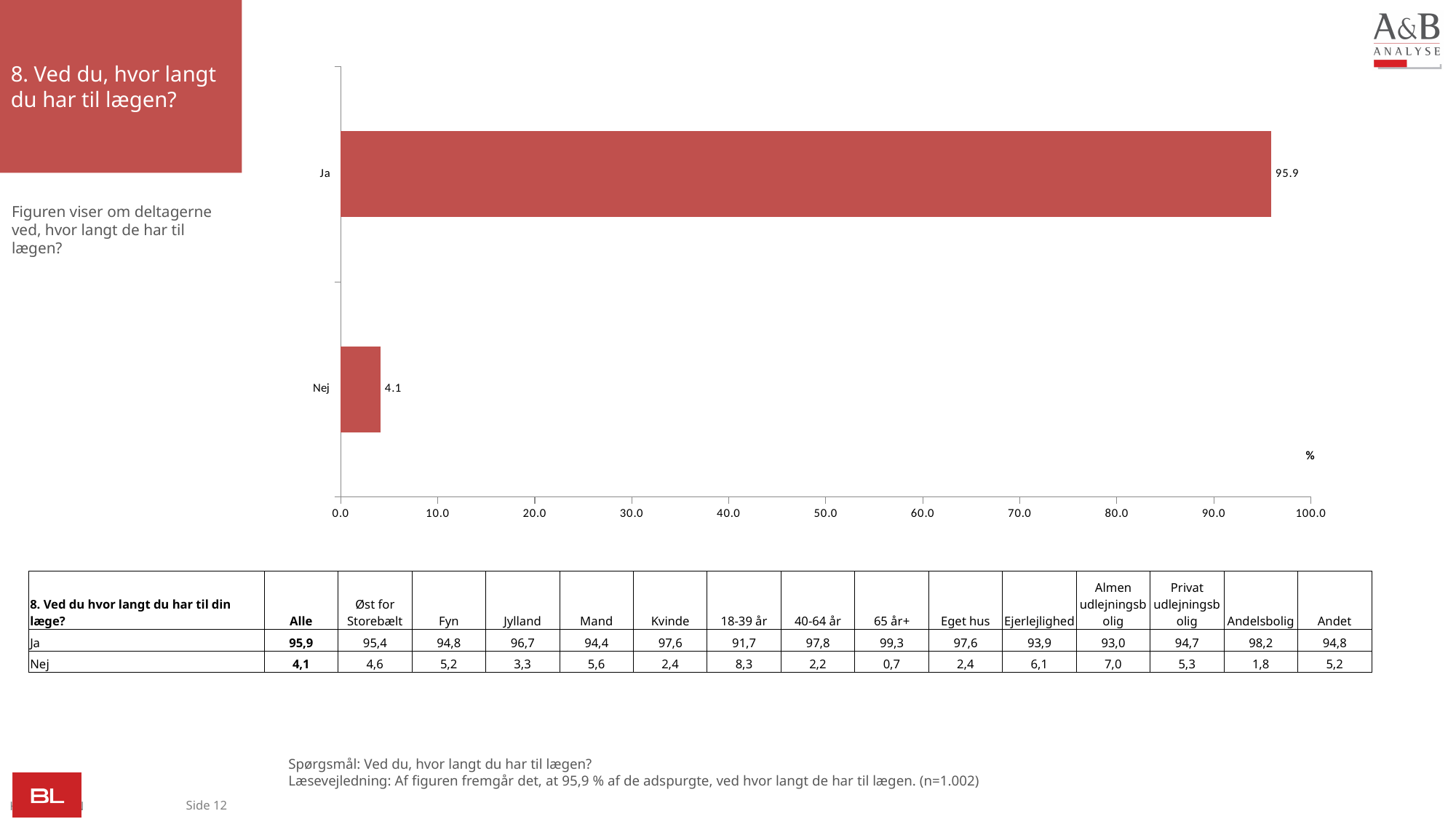
What is the difference between the values for Ja and Nej in the chart? 91.8 What is the value for Nej in the chart? 4.1 What kind of chart is shown on the slide? bar chart What is the value for Ja in the chart? 95.9 Is the value for Nej greater or less than 10.0? less Is the value for Ja greater or less than 90.0? greater Which category has the highest value in the chart? Ja What is the maximum value shown on the x axis of the chart? 100.0 Which category has the lowest value in the chart? Nej What unit label is shown at the end of the x axis of the chart? % Which is larger in the chart, the value for Ja or the value for Nej? Ja How many categories are shown in the chart? 2